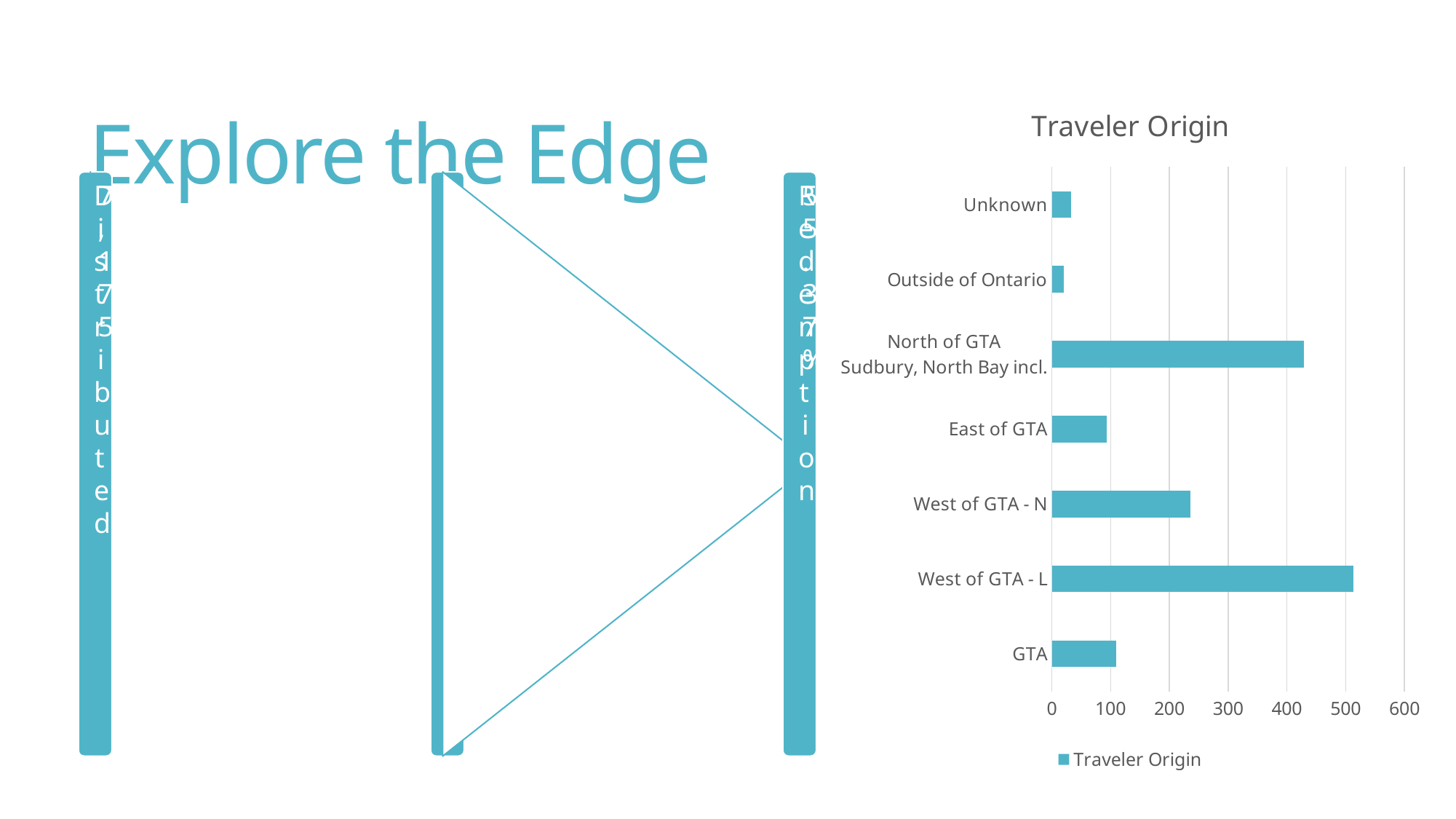
Is the value for West of GTA - L greater or less than 500? greater Which category has the highest value on the Traveler Origin chart? West of GTA - L Which is larger on the Traveler Origin chart, West of GTA - N or GTA? West of GTA - N What kind of chart is the Traveler Origin chart? bar chart How many categories are shown on the Traveler Origin chart? 7 What is the title of the chart on the slide? Traveler Origin Which is larger on the Traveler Origin chart, North of GTA Sudbury, North Bay incl. or East of GTA? North of GTA Sudbury, North Bay incl. Is the value for Unknown greater or less than 100? less How many series does the legend of the Traveler Origin chart list? 1 Is the value for West of GTA - N greater or less than 200? greater